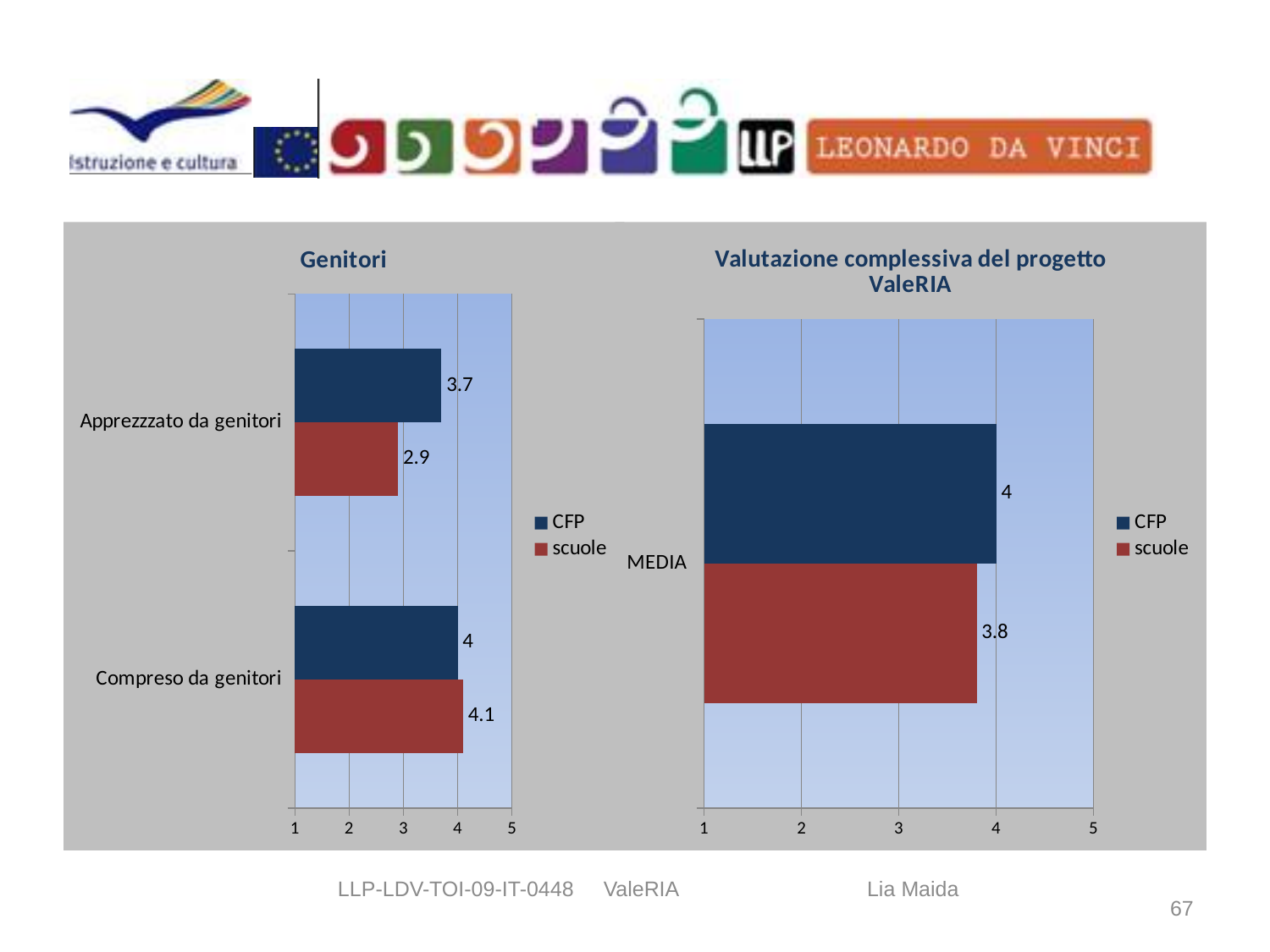
In the 'Genitori' chart, what is the scuole value for 'Apprezzzato da genitori'? 2.9 In the 'Valutazione complessiva del progetto ValeRIA' chart, what is the difference between the CFP and scuole values? 0.2 How many categories are shown in the 'Genitori' chart? 2 In the 'Genitori' chart, which bar has the lowest value? scuole, Apprezzzato da genitori In the 'Genitori' chart, what is the difference between the CFP and scuole values for 'Apprezzzato da genitori'? 0.8 What type of chart is the 'Genitori' chart? bar chart In the 'Valutazione complessiva del progetto ValeRIA' chart, what is the CFP value for MEDIA? 4 In the 'Genitori' chart, what is the scuole value for 'Compreso da genitori'? 4.1 In the 'Genitori' chart, what is the CFP value for 'Apprezzzato da genitori'? 3.7 In the 'Valutazione complessiva del progetto ValeRIA' chart, what is the scuole value for MEDIA? 3.8 In the 'Genitori' chart, which series has the larger value for 'Compreso da genitori', CFP or scuole? scuole How many series does the legend of the 'Valutazione complessiva del progetto ValeRIA' chart list? 2